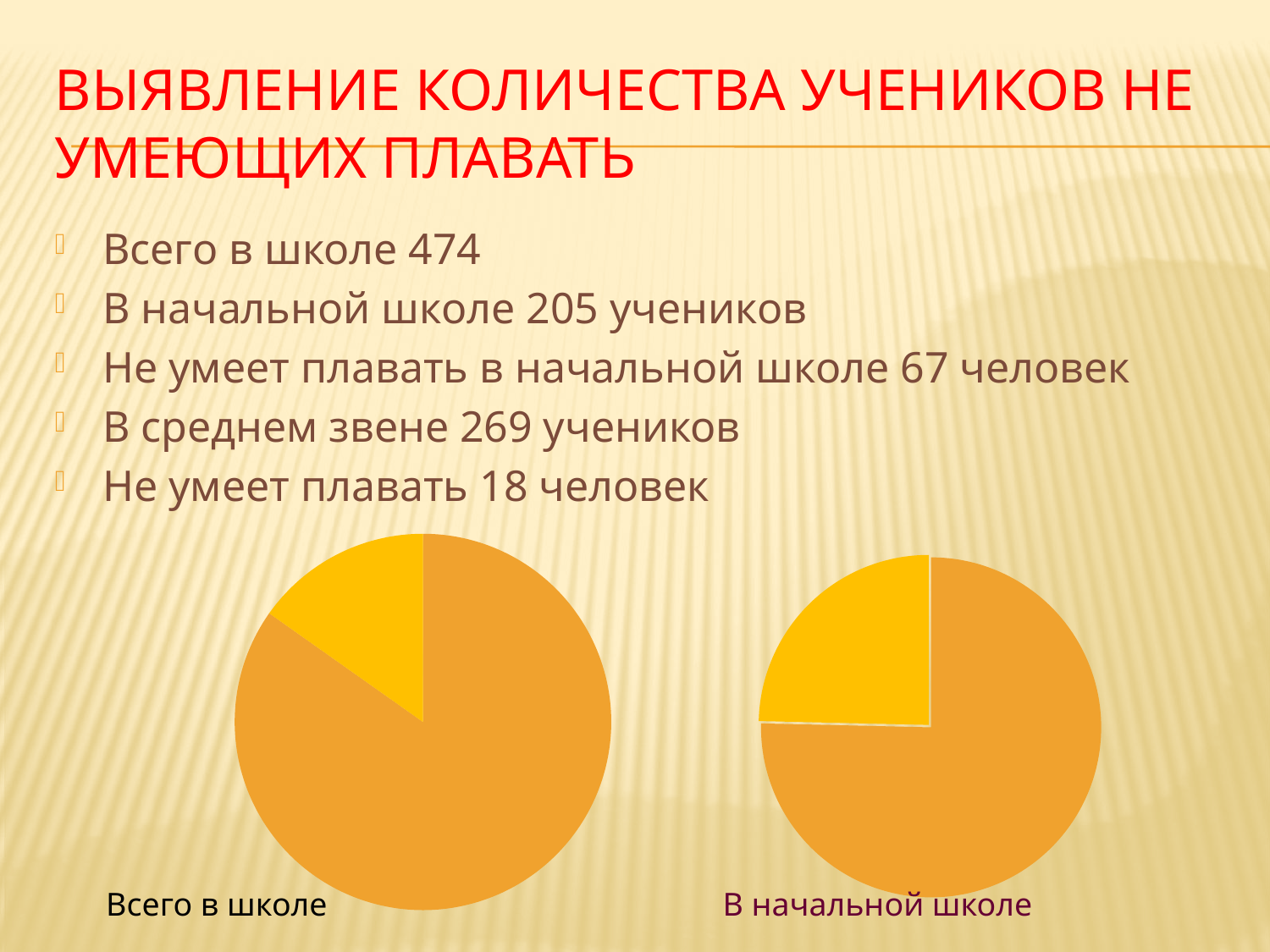
In the pie chart captioned "В начальной школе", which slice is larger, the orange one or the yellow one? the orange one What is the caption under the right pie chart? В начальной школе In the pie chart captioned "Всего в школе", which slice is larger, the orange one or the yellow one? the orange one What kind of chart is the one captioned "Всего в школе"? pie chart How many slices does the pie chart captioned "Всего в школе" have? 2 How many slices does the pie chart captioned "В начальной школе" have? 2 How many pie charts are shown on the slide? 2 What is the caption under the left pie chart? Всего в школе What kind of chart is the one captioned "В начальной школе"? pie chart In the pie chart captioned "В начальной школе", is the yellow slice greater or less than half of the pie? less